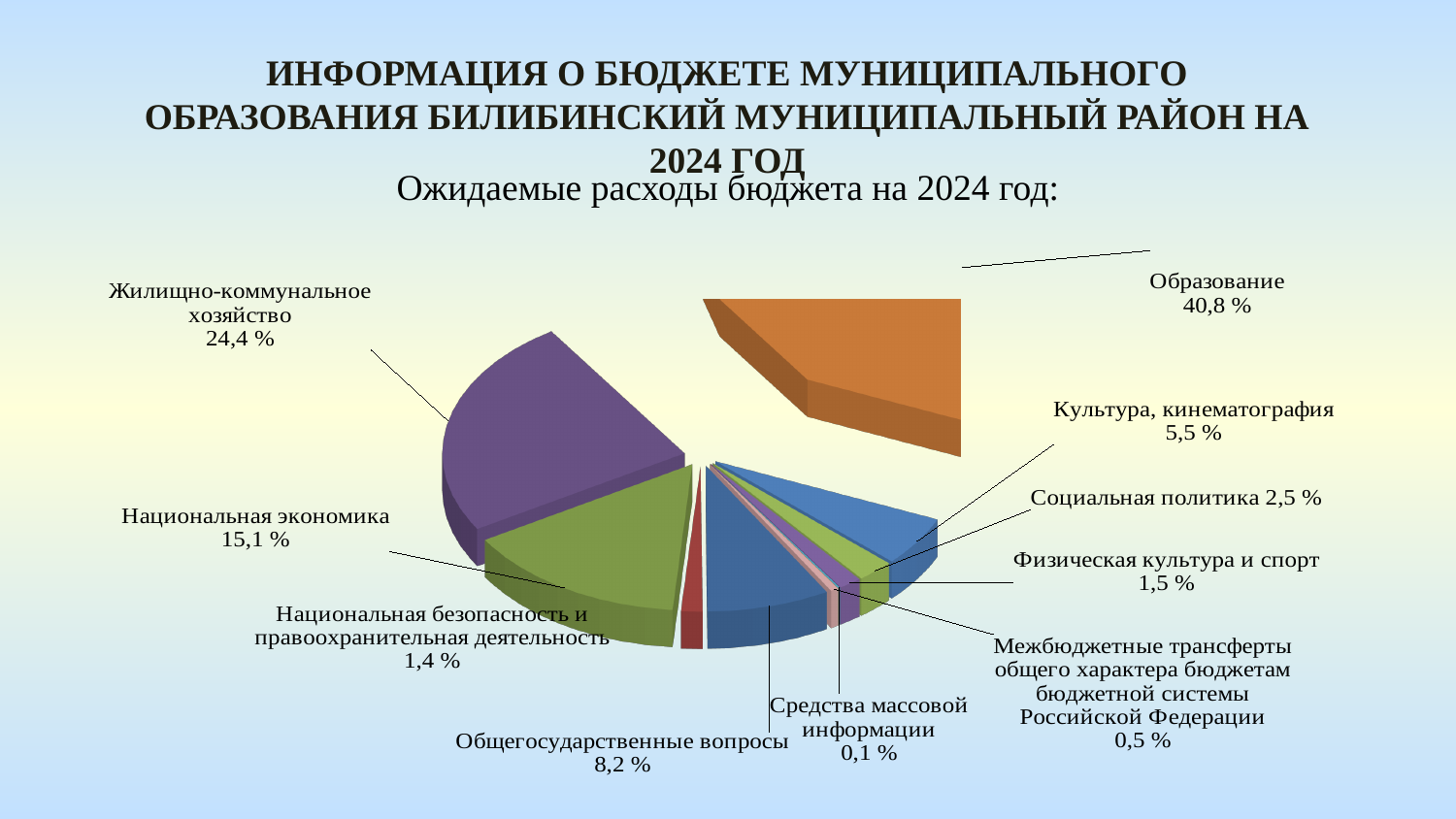
What share of expected 2024 budget expenditure goes to Образование? 40,8 % What is the difference in percentage points between Образование and Жилищно-коммунальное хозяйство? 16,4 What share is shown for Средства массовой информации? 0,1 % Which is larger: the share for Культура, кинематография or the share for Социальная политика? Культура, кинематография What share is shown for Национальная экономика? 15,1 % Which category has the largest share of the pie? Образование How many categories are shown in the pie chart? 10 What kind of chart is shown on the slide? pie chart What is the subtitle of the chart on the slide? Ожидаемые расходы бюджета на 2024 год: Which category has the smallest share of the pie? Средства массовой информации What share is shown for Общегосударственные вопросы? 8,2 % What share is shown for Жилищно-коммунальное хозяйство? 24,4 %